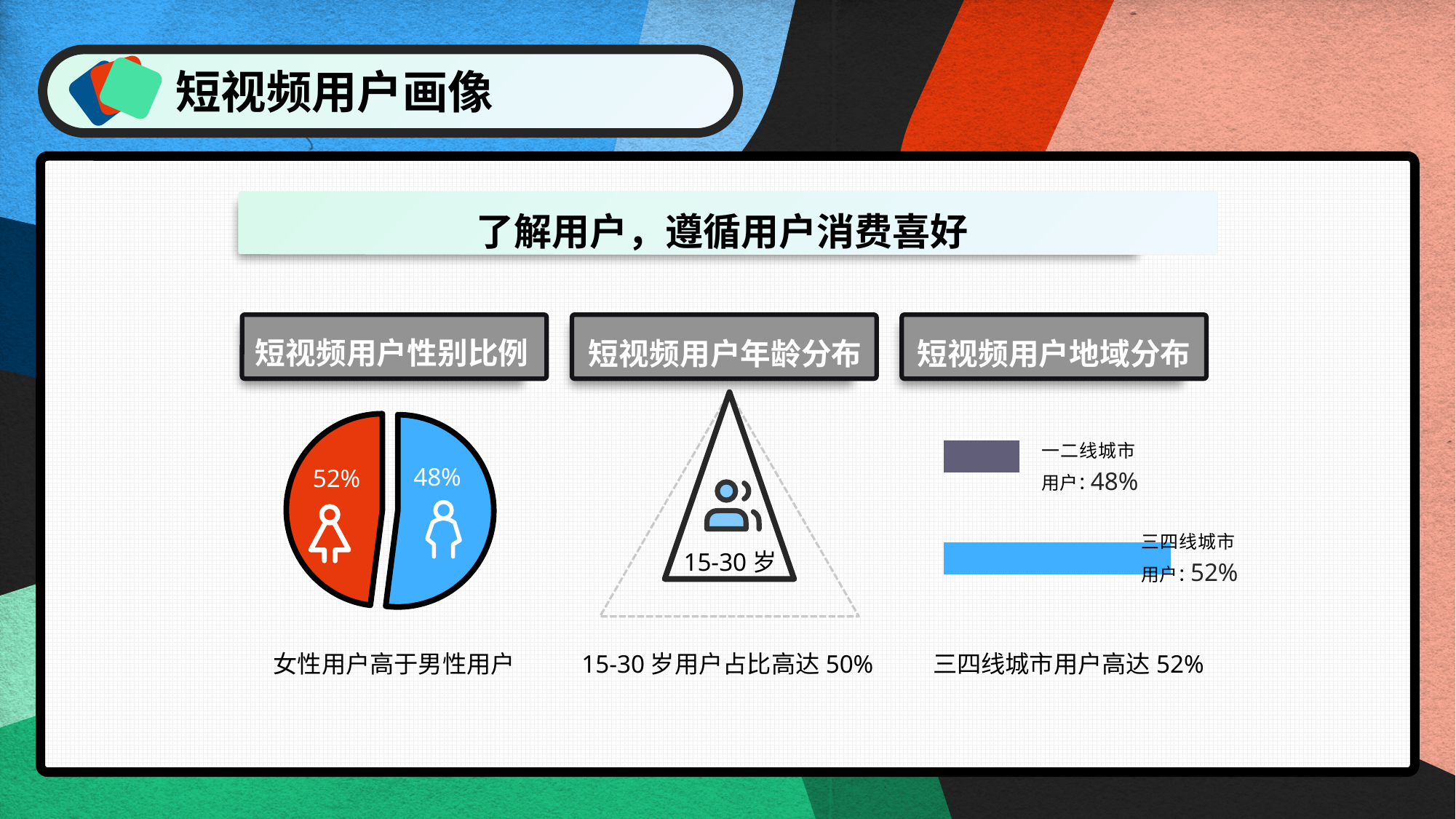
In the 短视频用户地域分布 chart, what is the value for 三四线城市用户? 52% In the 短视频用户地域分布 chart, what is the value for 一二线城市用户? 48% What kind of chart is used for 短视频用户地域分布? bar chart In the 短视频用户性别比例 chart, which slice is larger, female or male? female In the 短视频用户性别比例 chart, what is the difference between the female and male shares? 4% In the 短视频用户地域分布 chart, which category has the higher value? 三四线城市用户 How many slices does the 短视频用户性别比例 pie chart have? 2 What kind of chart is used for 短视频用户性别比例? pie chart In the 短视频用户性别比例 chart, what share of users is female (the red slice)? 52% In the 短视频用户性别比例 chart, what share of users is male (the blue slice)? 48% In the 短视频用户地域分布 chart, what is the difference between 三四线城市用户 and 一二线城市用户? 4% In the 短视频用户年龄分布 chart, what age group is shown in the pyramid and what share does the caption give it? 15-30 岁, 50%